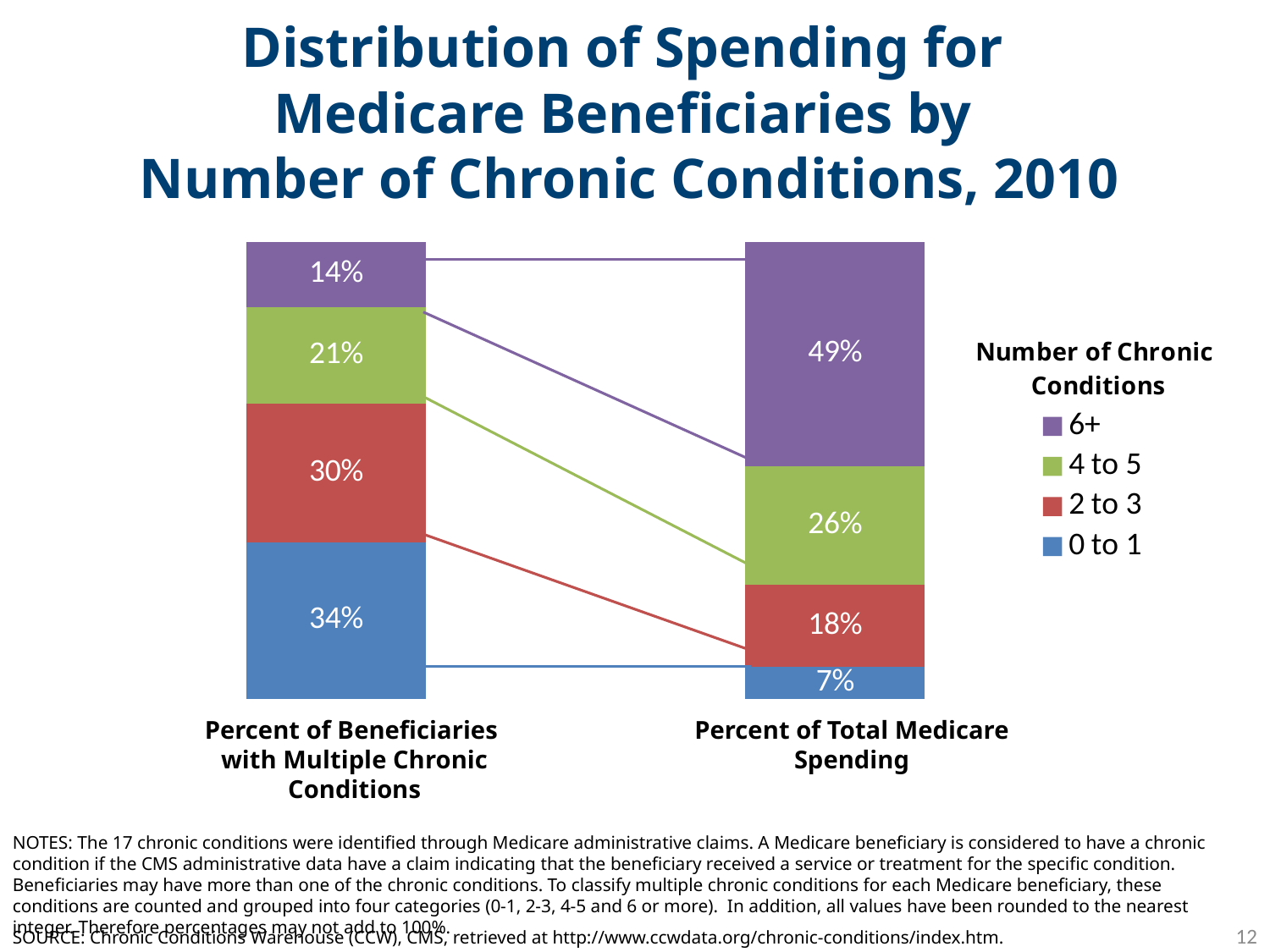
Which chronic condition group accounts for the smallest share of total Medicare spending? 0 to 1 What percent of beneficiaries with multiple chronic conditions have 0 to 1 chronic conditions? 34% Is the share of beneficiaries with 0 to 1 chronic conditions larger or smaller than their share of total Medicare spending? larger What is the difference between the share of spending and the share of beneficiaries for the 6+ group? 35 percentage points Which chronic condition group accounts for the largest share of total Medicare spending? 6+ What percent of total Medicare spending goes to beneficiaries with 6+ chronic conditions? 49% How many bars are shown in the chart? 2 What percent of total Medicare spending goes to beneficiaries with 2 to 3 chronic conditions? 18% How many series does the legend list? 4 What type of chart is shown on the slide? Stacked bar chart What percent of beneficiaries have 4 to 5 chronic conditions? 21% Which chronic condition group makes up the smallest share of beneficiaries? 6+